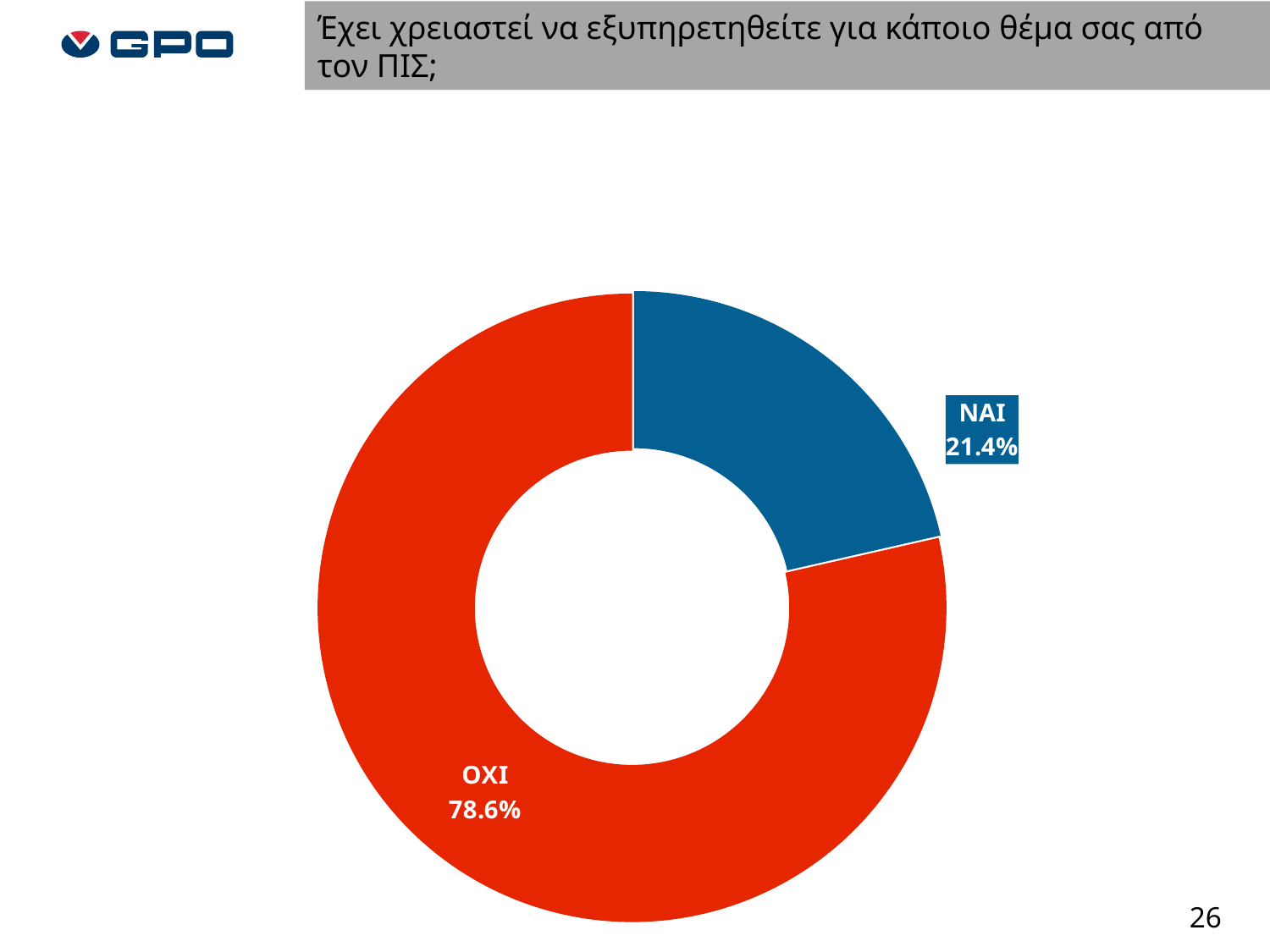
What percentage of respondents answered ΟΧΙ? 78.6% What share of the pie does the ΟΧΙ slice represent? 78.6% How many categories are shown in the chart? 2 Which response has the largest share of the chart? ΟΧΙ What is the difference in percentage points between ΟΧΙ and ΝΑΙ? 57.2 Which is larger, the share for ΝΑΙ or the share for ΟΧΙ? ΟΧΙ What percentage of respondents answered ΝΑΙ? 21.4% What kind of chart is shown on the slide? Pie chart (doughnut) What colour is the ΝΑΙ slice? Blue What colour is the ΟΧΙ slice? Red Which response has the smallest share of the chart? ΝΑΙ